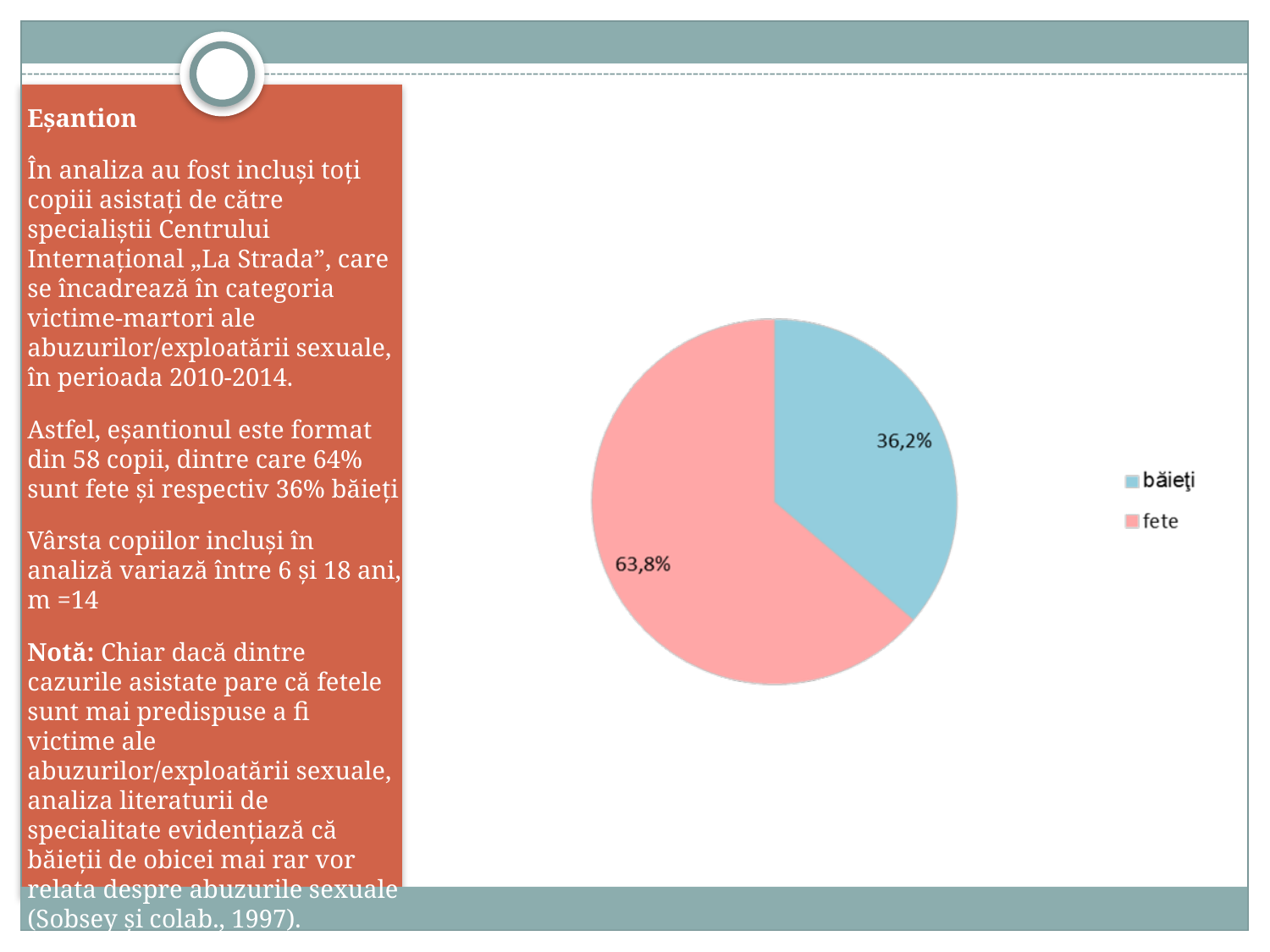
What is the difference in percentage points between the "fete" and "băieți" slices? 27,6 What percentage of the pie chart is labelled for "băieți"? 36,2% Which category has the largest slice of the pie chart? fete What colour is the "băieți" slice in the pie chart? light blue What colour is the "fete" slice in the pie chart? pink How many entries does the legend of the pie chart list? 2 What kind of chart is shown on the slide? pie chart How many slices does the pie chart have? 2 Which slice is larger, "băieți" or "fete"? fete What percentage of the pie chart is labelled for "fete"? 63,8% Which category has the smallest slice of the pie chart? băieți